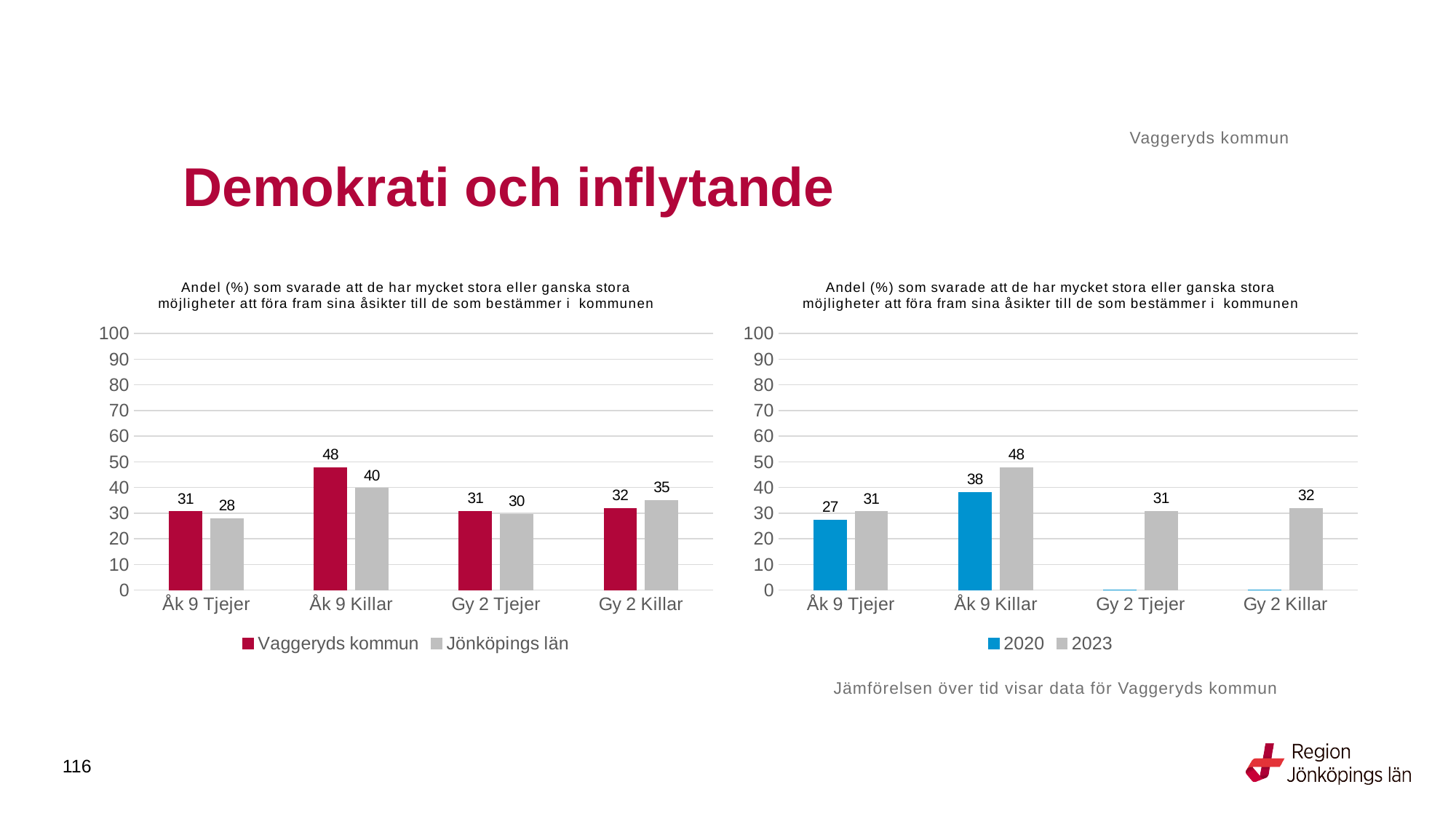
In the right chart, what is the difference between 2023 and 2020 for Åk 9 Killar? 10 In the left chart, what is the value for Vaggeryds kommun for Åk 9 Killar? 48 In the left chart, what is the value for Jönköpings län for Gy 2 Killar? 35 In the right chart, which category has the lowest value for 2023? Åk 9 Tjejer and Gy 2 Tjejer (both 31) In the left chart, how many series does the legend list? 2 In the left chart, which is larger for Gy 2 Killar: Vaggeryds kommun or Jönköpings län? Jönköpings län In the left chart, which category has the highest value for Jönköpings län? Åk 9 Killar In the right chart, what is the value for 2023 for Åk 9 Killar? 48 In the left chart, what is the difference between Vaggeryds kommun and Jönköpings län for Åk 9 Killar? 8 In the right chart, how many categories are shown on the x axis? 4 In the right chart, what is the value for 2020 for Åk 9 Tjejer? 27 What type of chart is the right chart? Bar chart